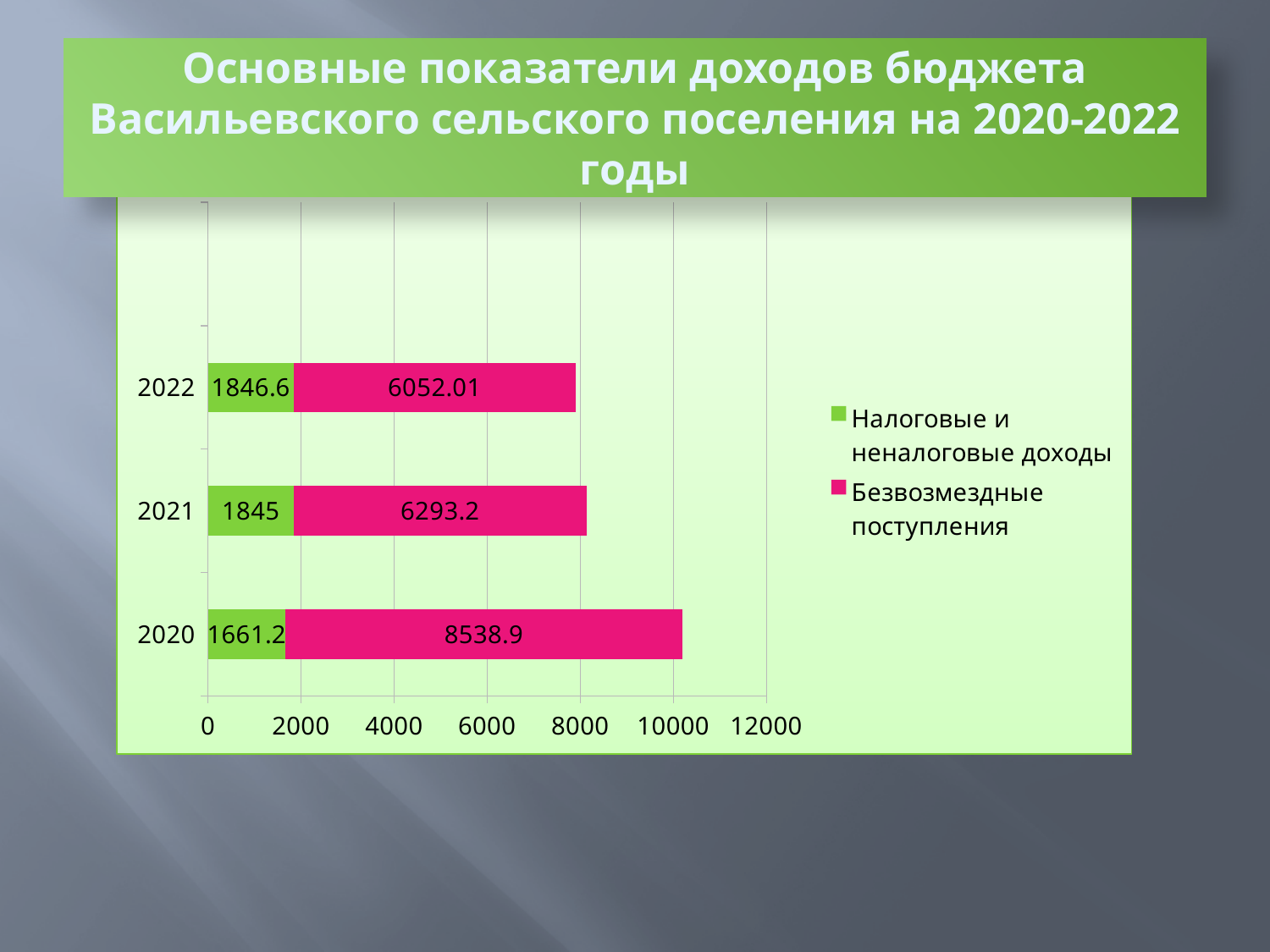
How many series does the legend list? 2 What is the value of Безвозмездные поступления for 2021? 6293.2 Which is larger: Безвозмездные поступления in 2021 or in 2022? 2021 What is the total of the stacked bar for 2021? 8138.2 What is the difference between Безвозмездные поступления in 2020 and in 2021? 2245.7 What is the value of Налоговые и неналоговые доходы for 2022? 1846.6 In which year is Налоговые и неналоговые доходы the lowest? 2020 How many years are shown on the chart? 3 What is the value of Налоговые и неналоговые доходы for 2020? 1661.2 What is the total of the stacked bar for 2020? 10200.1 In which year is Безвозмездные поступления the highest? 2020 What is the value of Безвозмездные поступления for 2020? 8538.9